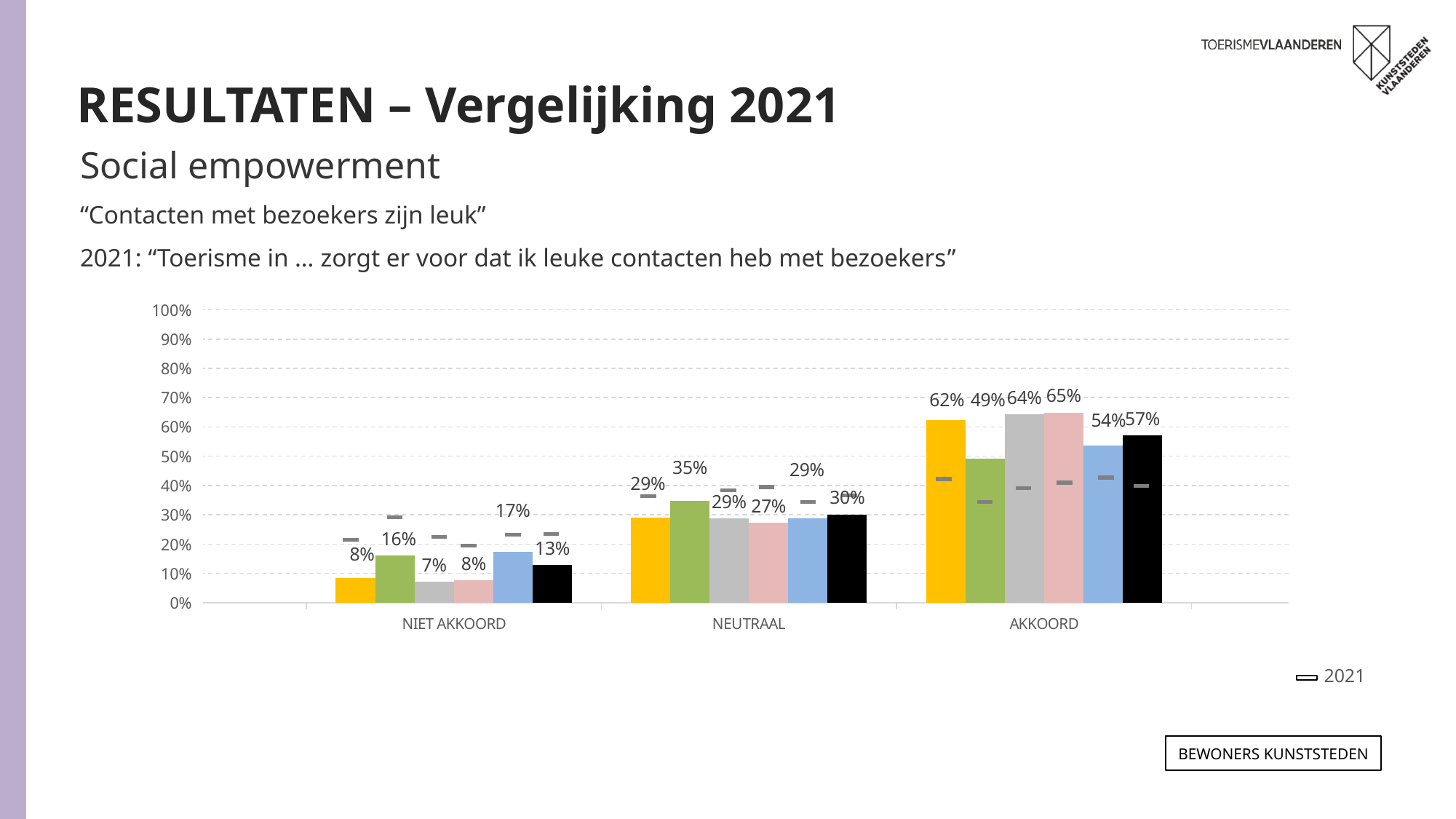
What is the value of the green bar in the NEUTRAAL category? 35% What is the value of the blue bar in the NIET AKKOORD category? 17% What entry does the chart legend list? 2021 What type of chart is shown on the slide? bar chart Which bar has the lowest value in the NIET AKKOORD category? the grey bar (7%) Which bar has the highest value in the AKKOORD category? the pink bar (65%) How many categories are shown on the x axis of the chart? 3 What is the value of the yellow bar in the AKKOORD category? 62% In the NEUTRAAL category, which is larger: the green bar or the black bar? the green bar What is the value of the black bar in the AKKOORD category? 57% Is the 2021 marker for the green bar in the AKKOORD category greater or less than 40%? less What is the difference between the yellow bar in AKKOORD and the yellow bar in NIET AKKOORD? 54 percentage points